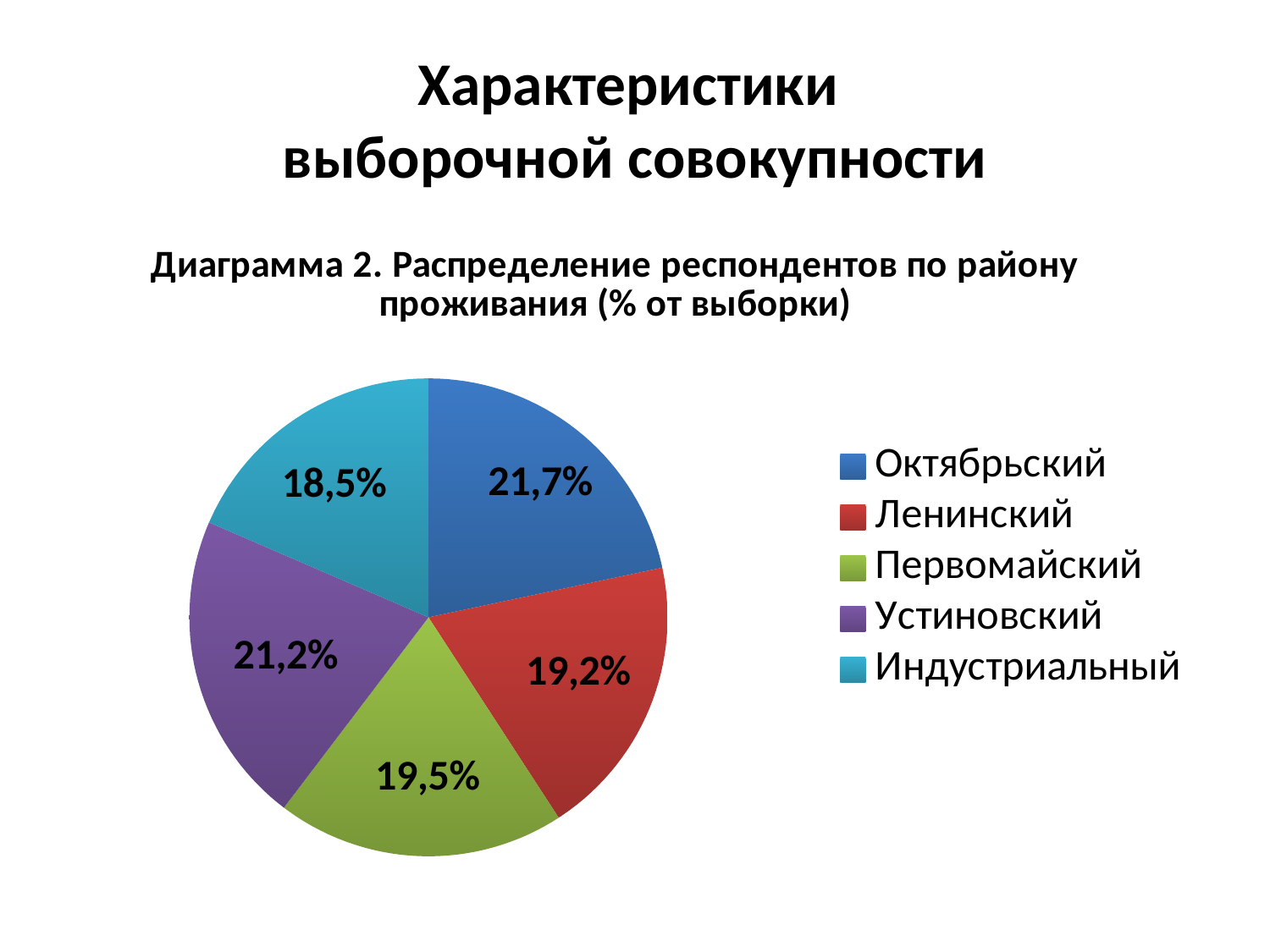
What share of respondents live in the Октябрьский district? 21,7% Which has a larger share of respondents, Ленинский or Первомайский? Первомайский Which district has the largest share of respondents? Октябрьский What share of respondents live in the Индустриальный district? 18,5% How many districts are shown in the pie chart? 5 What colour is the slice for the Устиновский district? Purple Which district has the smallest share of respondents? Индустриальный What share of respondents live in the Ленинский district? 19,2% What type of chart is shown on the slide? Pie chart What share of respondents live in the Первомайский district? 19,5% What is the difference in percentage points between the Октябрьский and Индустриальный shares? 3,2 What share of respondents live in the Устиновский district? 21,2%